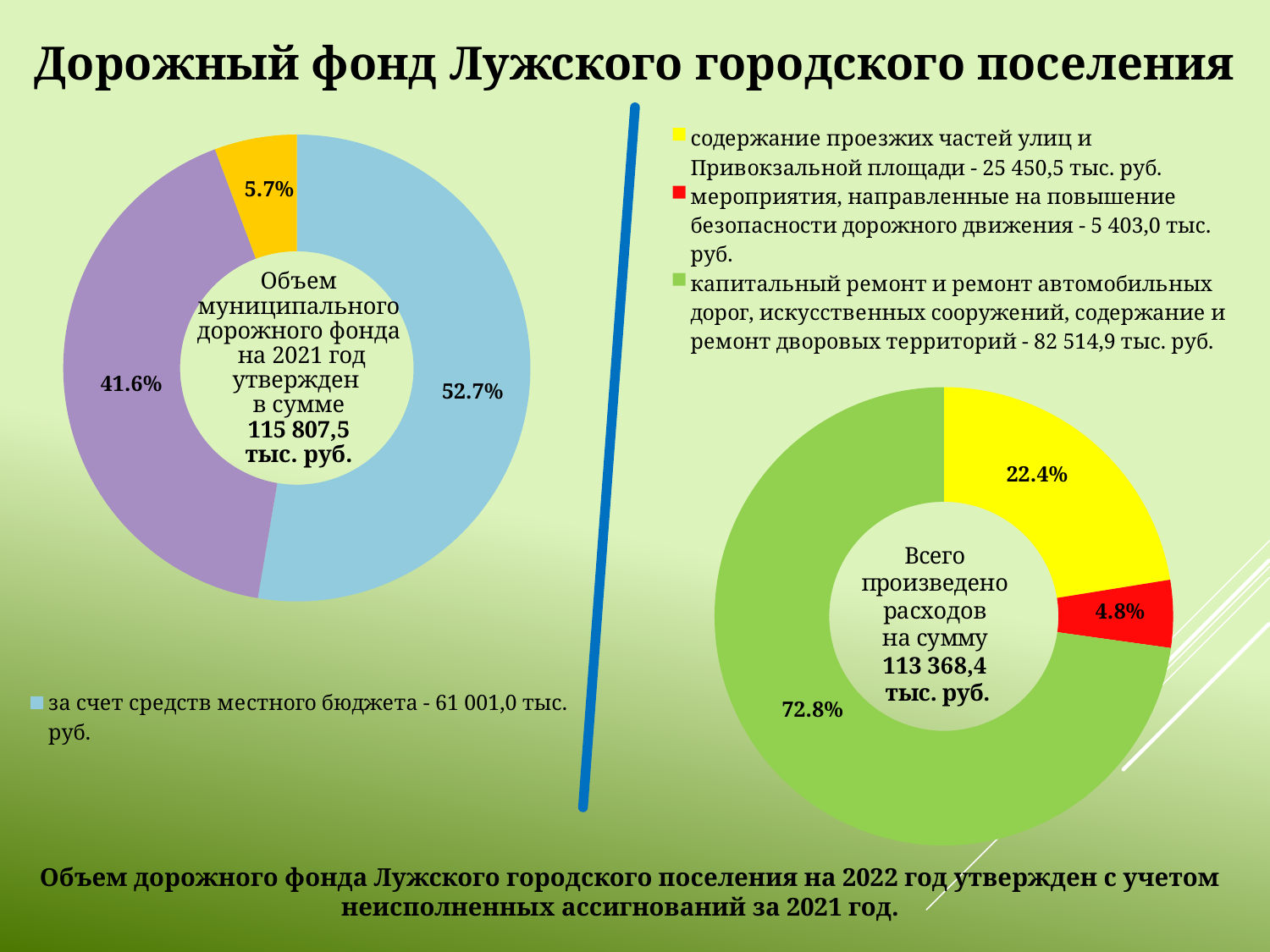
What kind of chart is the left chart on the slide? Doughnut (pie) chart In the right chart, what amount in thousand rubles is listed for road safety measures in the legend? 5 403,0 тыс. руб. In the left chart, what share of the 2021 municipal road fund comes from local budget funds (за счет средств местного бюджета)? 52.7% According to the left chart's centre text, what is the total approved volume of the municipal road fund for 2021? 115 807,5 тыс. руб. In the right chart, what is the difference in percentage points between the share for capital repair of roads and the share for maintenance of street carriageways? 50.4 percentage points How many slices does the left chart have? 3 In the right chart, what share of expenditures went to road safety measures (мероприятия, направленные на повышение безопасности дорожного движения)? 4.8% In the right chart, which category has the smallest share? мероприятия, направленные на повышение безопасности дорожного движения In the right chart, what share of expenditures went to maintenance of street carriageways and Privokzalnaya Square (содержание проезжих частей улиц)? 22.4% In the left chart, what is the smallest slice's share? 5.7% In the left chart, what is the largest slice's share? 52.7% In the right chart, what share of expenditures went to capital repair and repair of roads, engineering structures and courtyard areas (капитальный ремонт и ремонт автомобильных дорог)? 72.8%